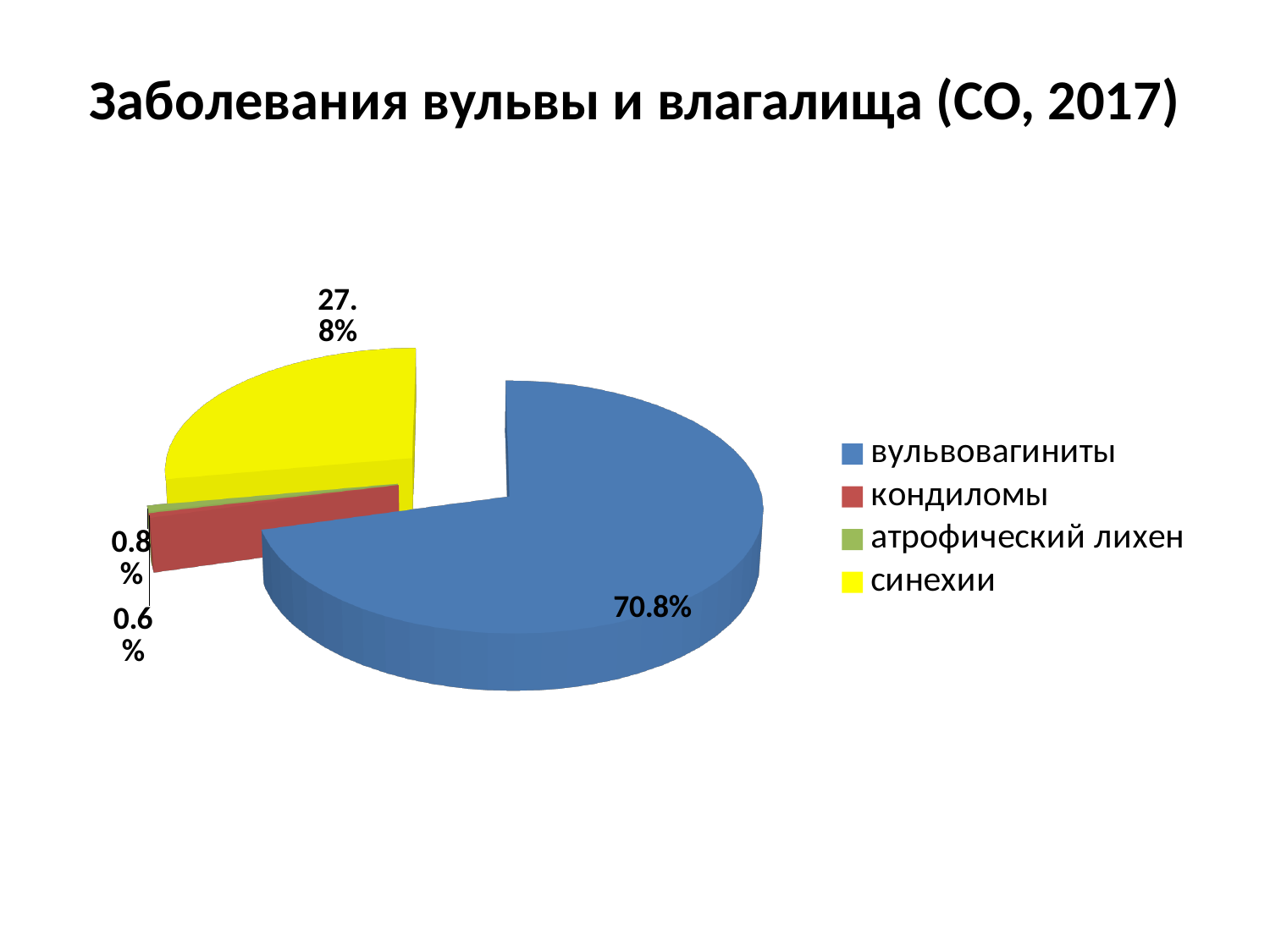
What share of the pie is синехии? 27.8% What is the title of the chart? Заболевания вульвы и влагалища (СО, 2017) What is the combined share of вульвовагиниты and синехии? 98.6% Which is larger, вульвовагиниты or синехии? вульвовагиниты Which category is shown in blue? вульвовагиниты How many categories does the legend list? 4 What colour is the slice for синехии? yellow What kind of chart is shown on the slide? pie chart Which category has the smallest slice? кондиломы What is the difference between the shares of вульвовагиниты and синехии? 43.0% Which category has the largest slice? вульвовагиниты What share of the pie is вульвовагиниты? 70.8%